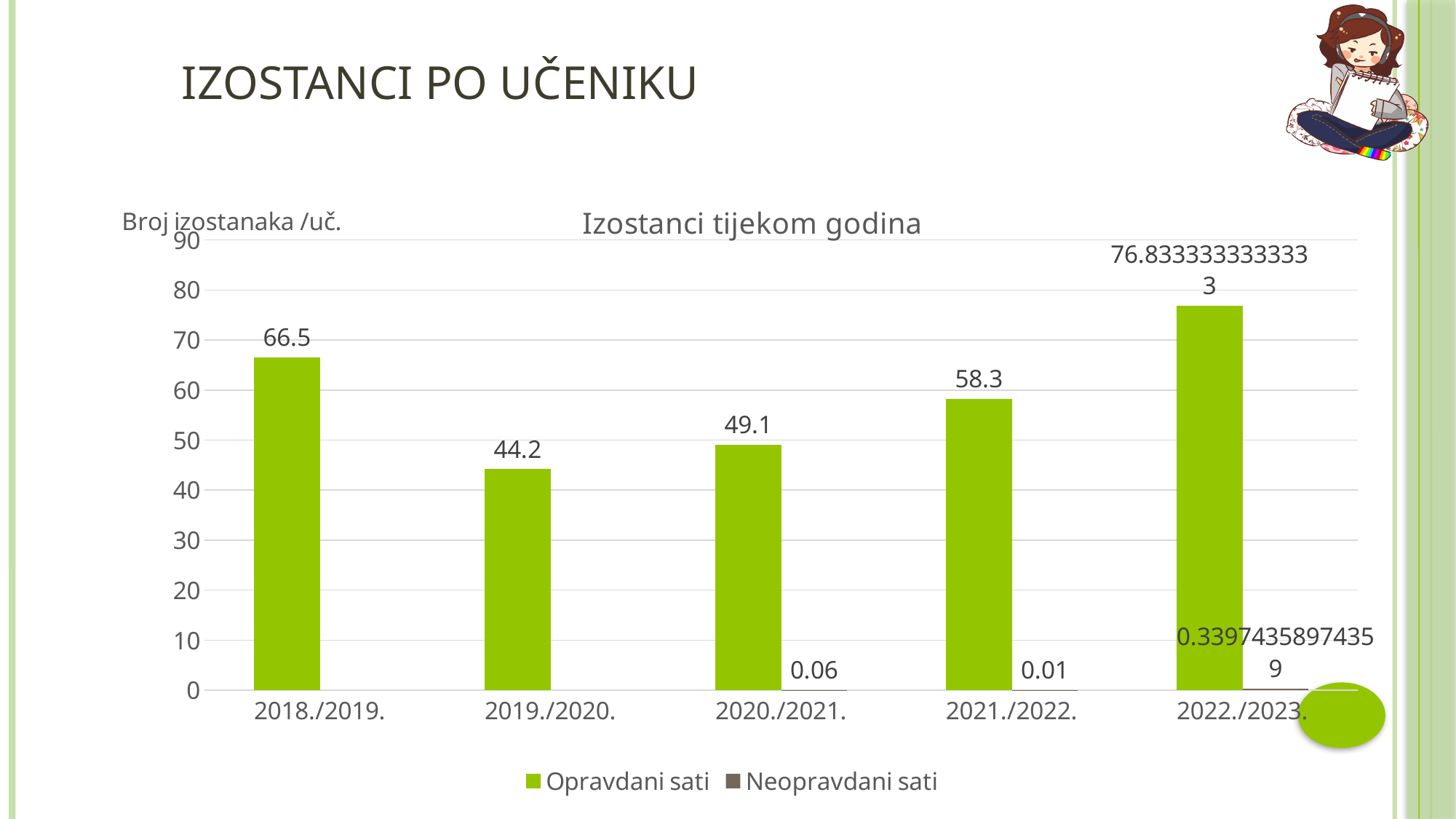
Is the value of Opravdani sati for 2022./2023. greater or less than 70? greater How many school years are shown on the x axis? 5 Which year has a larger value of Opravdani sati, 2020./2021. or 2021./2022.? 2021./2022. What is the value of Opravdani sati for 2018./2019.? 66.5 How many series does the legend list? 2 Which school year has the lowest value of Opravdani sati? 2019./2020. What is the value of Opravdani sati for 2021./2022.? 58.3 What is the value of Opravdani sati for 2019./2020.? 44.2 Which school year has the highest value of Opravdani sati? 2022./2023. What is the value of Neopravdani sati for 2020./2021.? 0.06 What is the difference in Opravdani sati between 2018./2019. and 2019./2020.? 22.3 What kind of chart is shown on the slide? bar chart